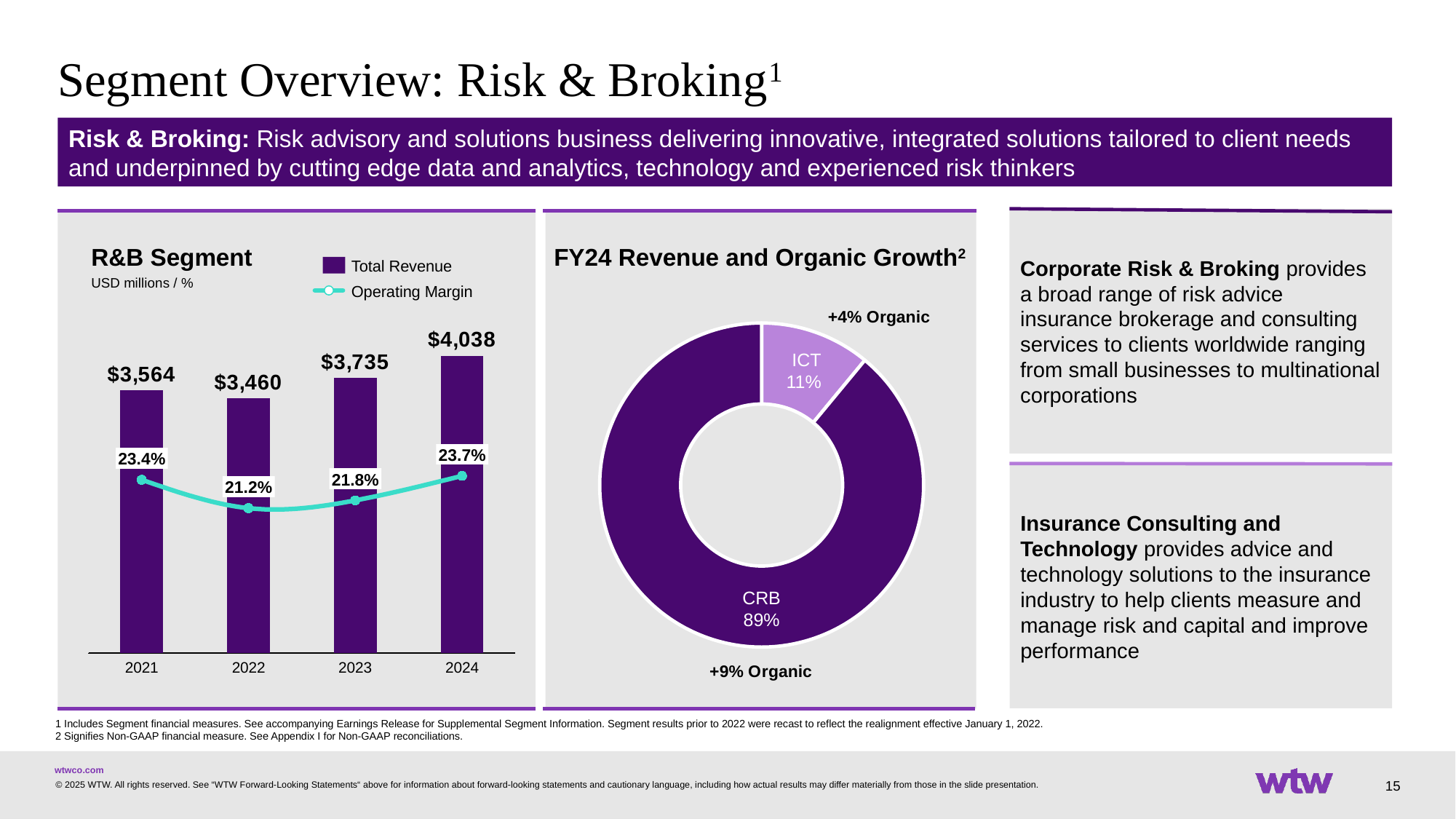
In the R&B Segment chart, what was Total Revenue in 2024? $4,038 In the R&B Segment chart, does Total Revenue rise or fall from 2022 to 2024? rise In the R&B Segment chart, was Total Revenue higher in 2021 or 2022? 2021 In the R&B Segment chart, how many years are shown on the x axis? 4 In the R&B Segment chart, how many series does the legend list? 2 What kind of chart is the FY24 Revenue and Organic Growth chart? doughnut chart In the R&B Segment chart, what was the Operating Margin in 2022? 21.2% In the FY24 Revenue and Organic Growth chart, what share of revenue does CRB represent? 89% In the FY24 Revenue and Organic Growth chart, what organic growth is shown for ICT? +4% Organic In the R&B Segment chart, what is the difference in Total Revenue between 2024 and 2023? $303 In the R&B Segment chart, which year had the lowest Operating Margin? 2022 In the R&B Segment chart, which year had the highest Total Revenue? 2024